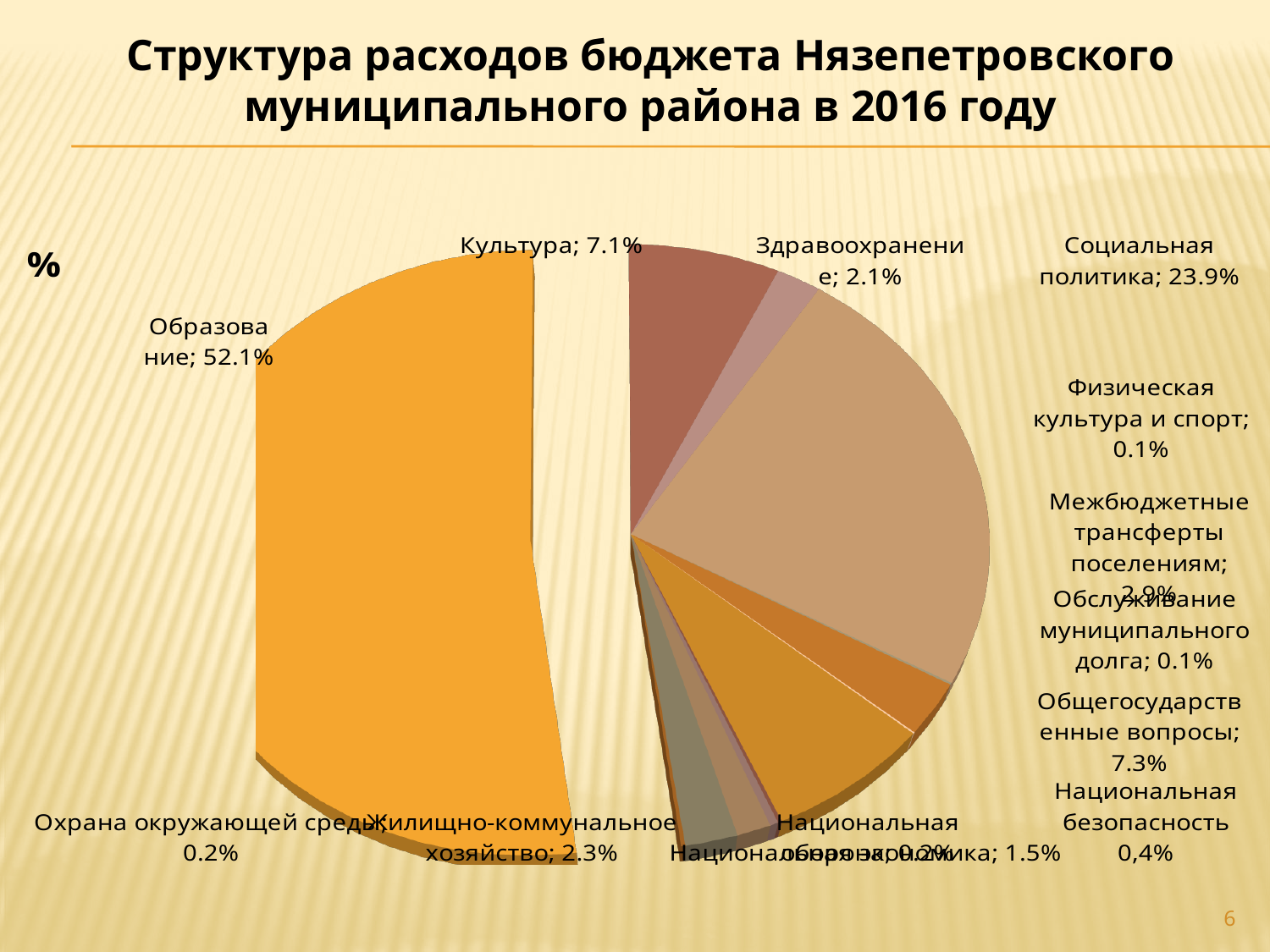
What share is labelled for Социальная политика? 23.9% What is the difference between the shares of Образование and Социальная политика? 28.2% What share of budget expenditure is labelled for Образование? 52.1% What share is labelled for Культура? 7.1% What type of chart is shown on the slide? pie chart What is the title of the slide? Структура расходов бюджета Нязепетровского муниципального района в 2016 году Which category has the largest share of the pie? Образование What share is labelled for Общегосударственные вопросы? 7.3% What share is labelled for Жилищно-коммунальное хозяйство? 2.3% What share is labelled for Национальная безопасность? 0,4% What share is labelled for Здравоохранение? 2.1% Which has the larger share, Культура or Общегосударственные вопросы? Общегосударственные вопросы